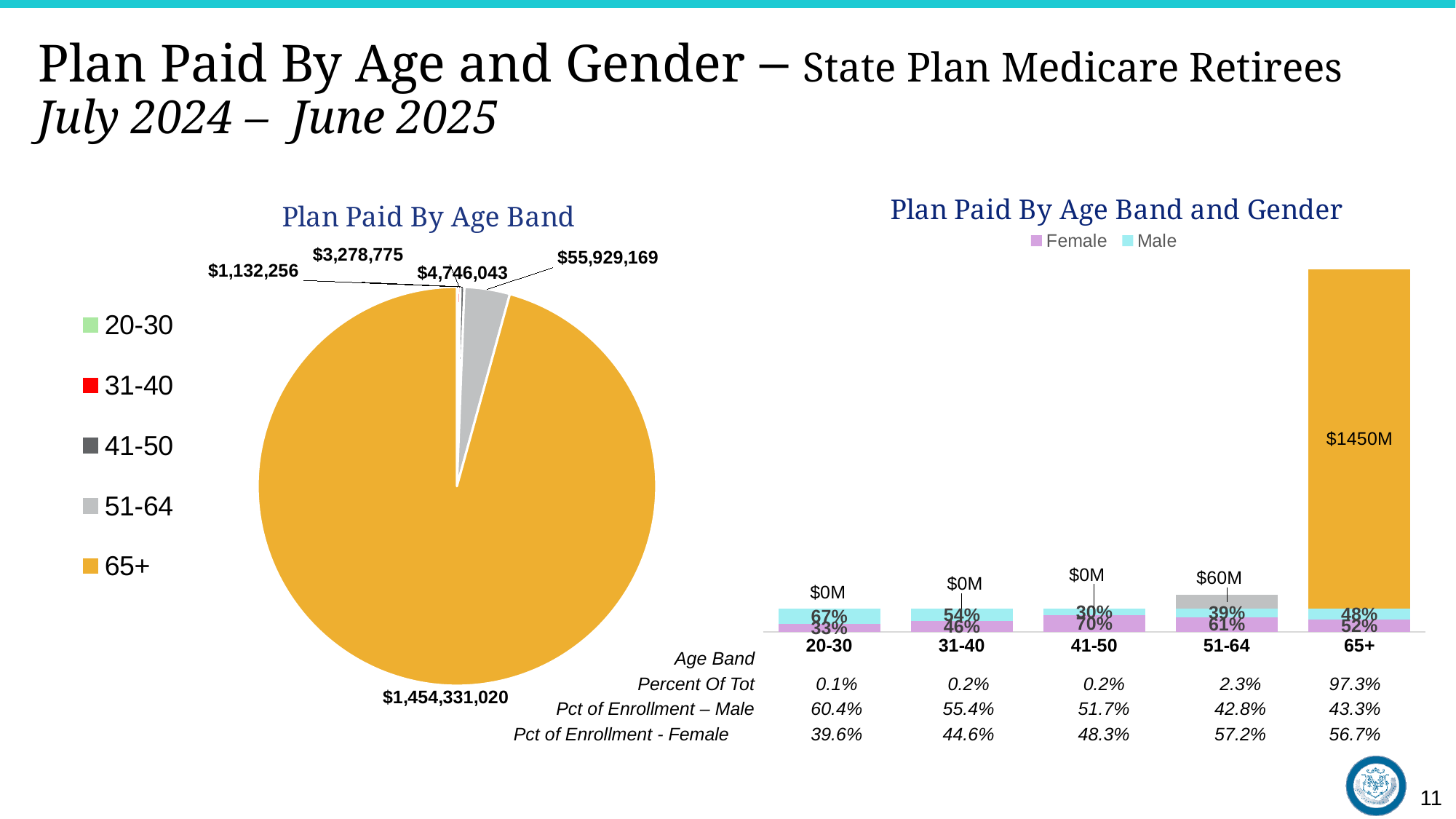
In the 'Plan Paid By Age Band and Gender' chart, what is the plan paid value for the 65+ age band? $1450M In the 'Plan Paid By Age Band' pie chart, what is the value for the 65+ age band? $1,454,331,020 In the 'Plan Paid By Age Band and Gender' chart, what is the Male percentage shown for the 20-30 age band? 67% In the 'Plan Paid By Age Band and Gender' chart, what is the Percent Of Tot shown for the 65+ age band? 97.3% In the 'Plan Paid By Age Band' pie chart, what is the value for the 51-64 age band? $55,929,169 In the 'Plan Paid By Age Band' pie chart, which age band has the largest slice? 65+ In the 'Plan Paid By Age Band and Gender' chart, what is the Female percentage shown for the 41-50 age band? 70% In the 'Plan Paid By Age Band and Gender' chart, what is the plan paid value for the 51-64 age band? $60M In the 'Plan Paid By Age Band and Gender' chart, what is the difference between the plan paid values for 65+ and 51-64? $1390M How many age bands are listed in the legend of the 'Plan Paid By Age Band' pie chart? 5 What kind of chart is 'Plan Paid By Age Band'? Pie chart How many series does the legend of the 'Plan Paid By Age Band and Gender' chart list? 2